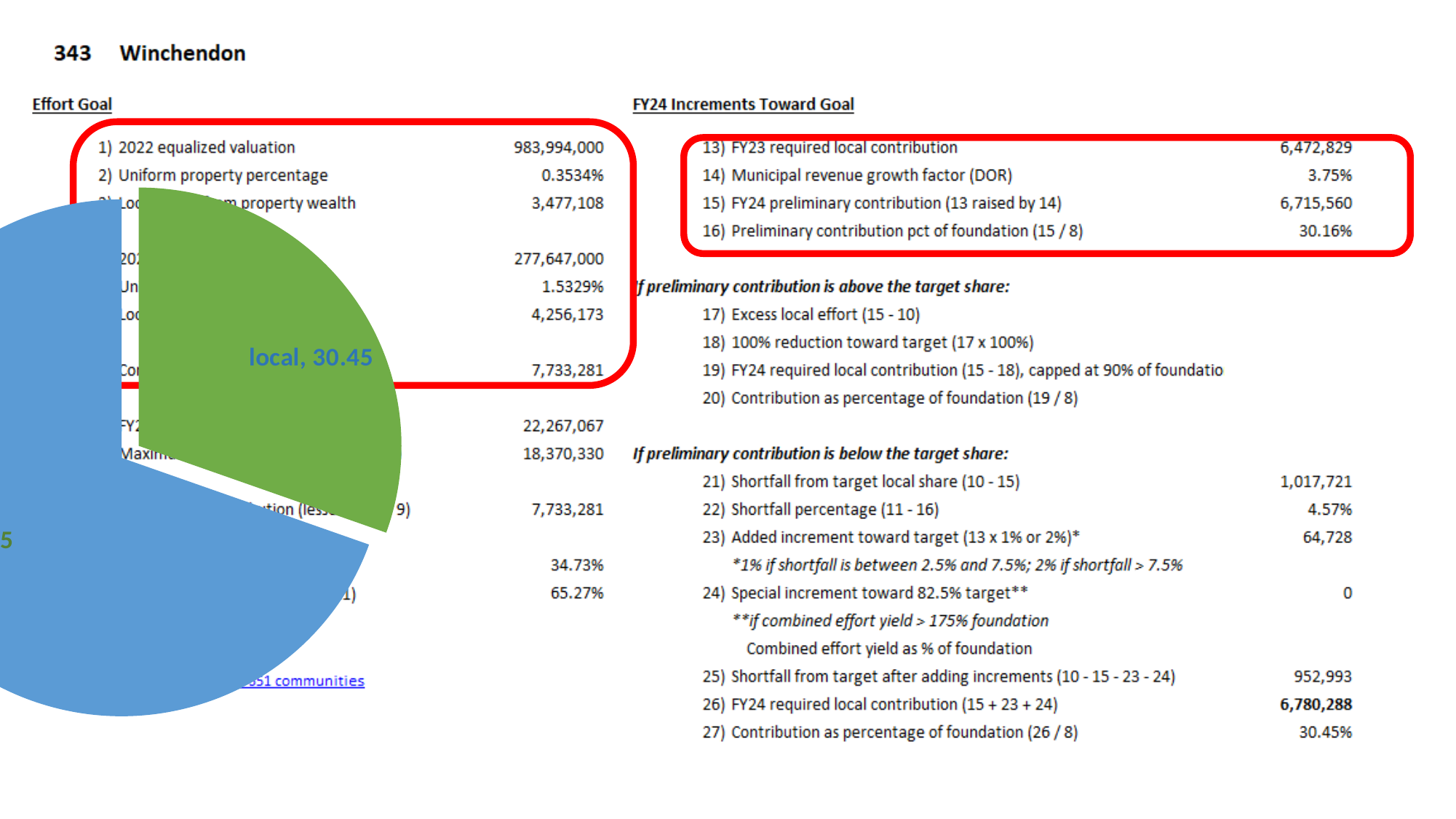
What value is shown for the "local" slice of the pie chart? 30.45 Is the "local" slice of the pie chart larger or smaller than the other slice? smaller What kind of chart is shown on the slide? pie chart Is the value for the "local" slice of the pie chart greater or less than 50? less What colour is the "local" slice of the pie chart? green How many slices does the pie chart have? 2